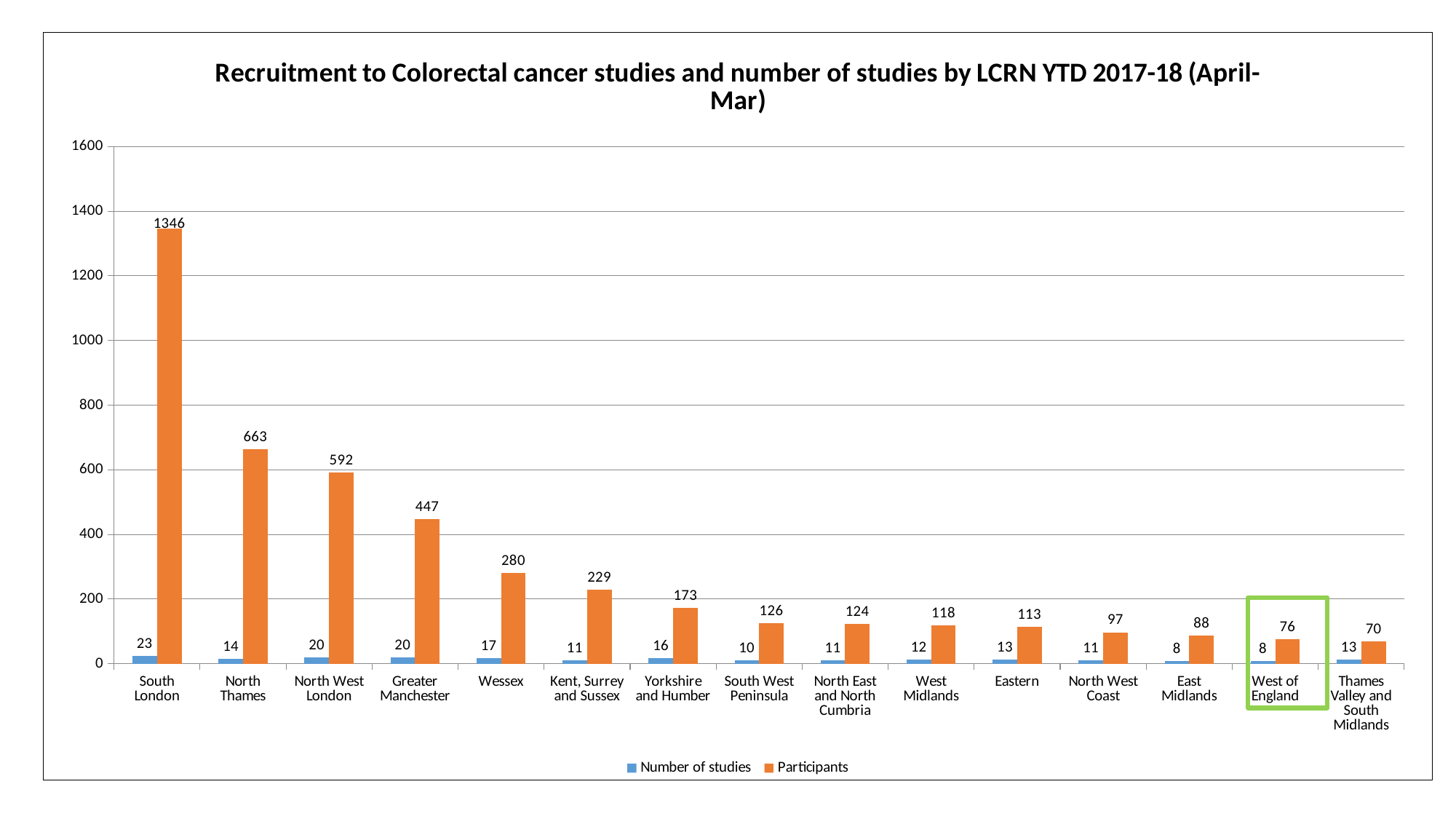
Which LCRN is highlighted with a green box? West of England How many series does the legend list? 2 Is the number of participants for Yorkshire and Humber greater or less than 200? less What is the number of studies for Greater Manchester? 20 What kind of chart is shown on the slide? bar chart What is the difference in participants between North Thames and North West London? 71 How many LCRNs are shown on the x axis? 15 Which has more participants, Wessex or Kent, Surrey and Sussex? Wessex Which LCRN has the lowest number of participants? Thames Valley and South Midlands How many participants were recruited in South London? 1346 How many participants were recruited in West of England? 76 Which LCRN has the highest number of participants? South London